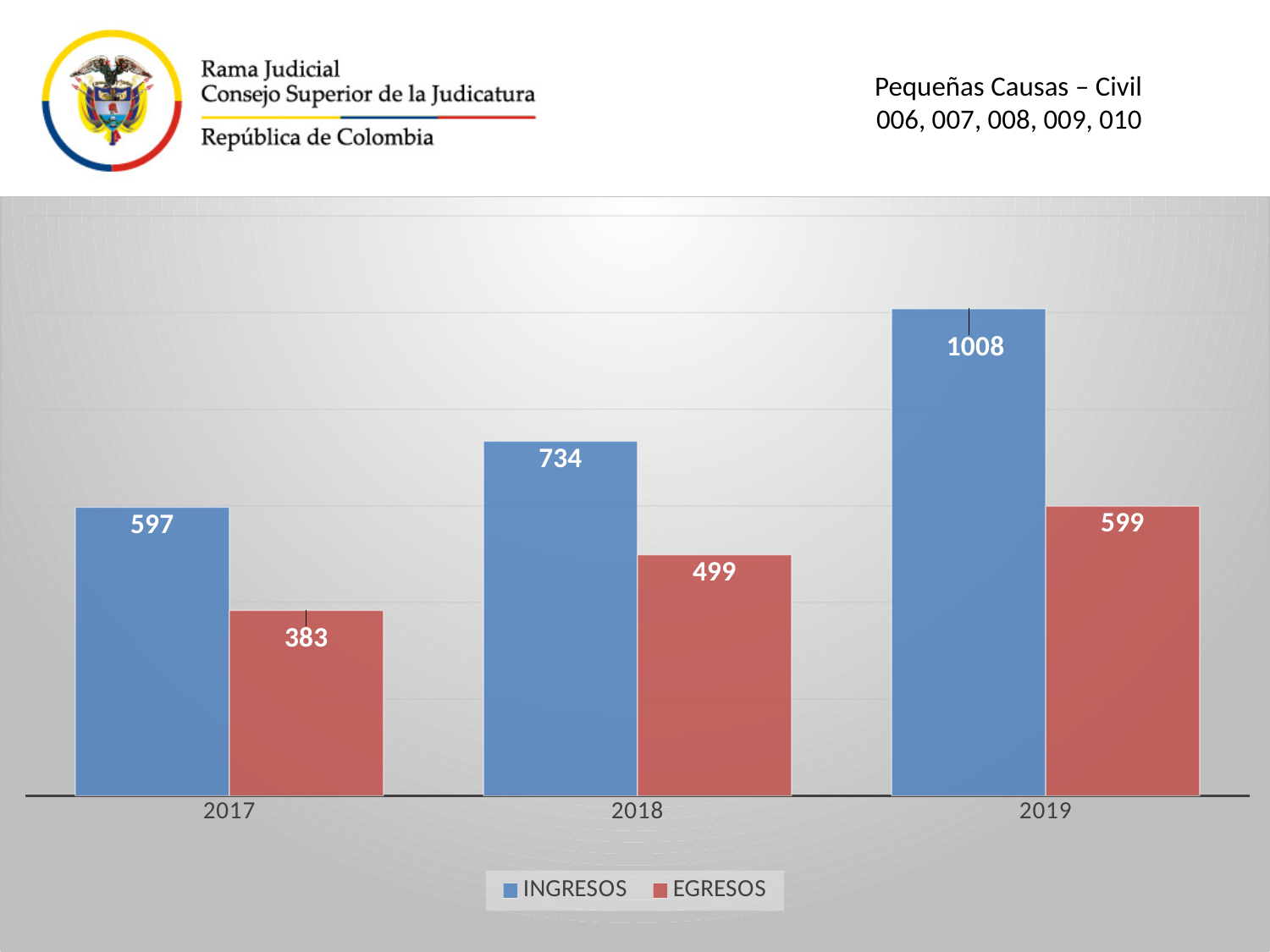
Which year has the lowest EGRESOS value? 2017 Which year has the highest INGRESOS value? 2019 Which is larger, INGRESOS in 2017 or EGRESOS in 2019? EGRESOS in 2019 What is the difference between INGRESOS and EGRESOS in 2019? 409 What is the difference between the EGRESOS values for 2018 and 2017? 116 How many series does the legend list? 2 How many years are shown on the x axis? 3 What is the INGRESOS value for 2018? 734 What is the EGRESOS value for 2017? 383 What kind of chart is shown on the slide? Bar chart What is the EGRESOS value for 2019? 599 What is the INGRESOS value for 2019? 1008